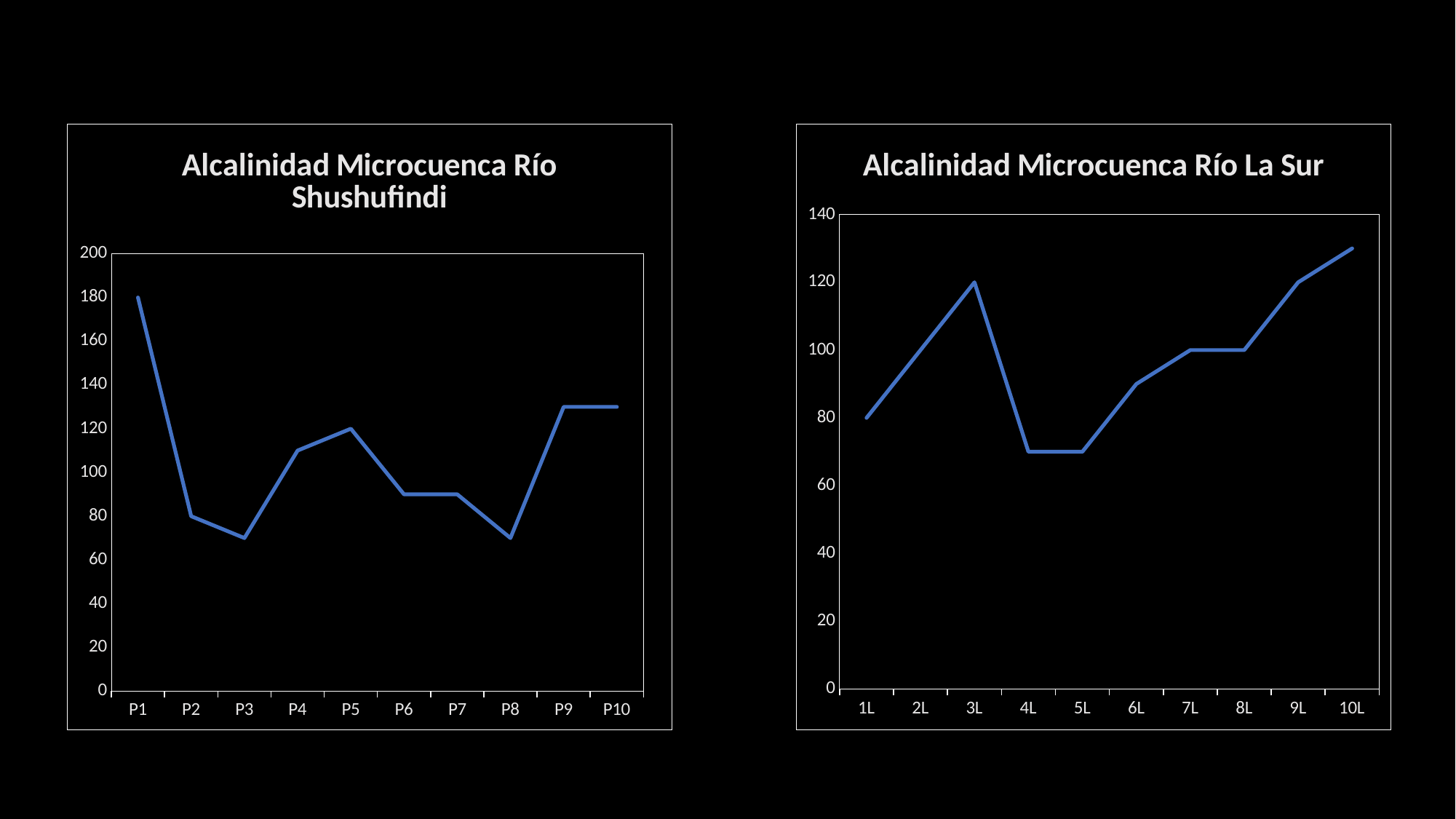
On the 'Alcalinidad Microcuenca Río Shushufindi' chart, is the value for P9 greater or less than 120? greater On the 'Alcalinidad Microcuenca Río Shushufindi' chart, what is the value for P2? 80 On the 'Alcalinidad Microcuenca Río Shushufindi' chart, which is larger, the value for P5 or the value for P6? P5 What kind of chart is the 'Alcalinidad Microcuenca Río Shushufindi' chart? line chart How many points are plotted on the 'Alcalinidad Microcuenca Río La Sur' chart? 10 On the 'Alcalinidad Microcuenca Río La Sur' chart, do the values rise or fall from 5L to 10L? rise On the 'Alcalinidad Microcuenca Río Shushufindi' chart, what is the value for P1? 180 On the 'Alcalinidad Microcuenca Río Shushufindi' chart, which point has the highest value? P1 What is the title of the chart on the right side of the slide? Alcalinidad Microcuenca Río La Sur On the 'Alcalinidad Microcuenca Río La Sur' chart, which point has the highest value? 10L On the 'Alcalinidad Microcuenca Río La Sur' chart, what is the value for 3L? 120 On the 'Alcalinidad Microcuenca Río La Sur' chart, is the value for 4L greater or less than 80? less